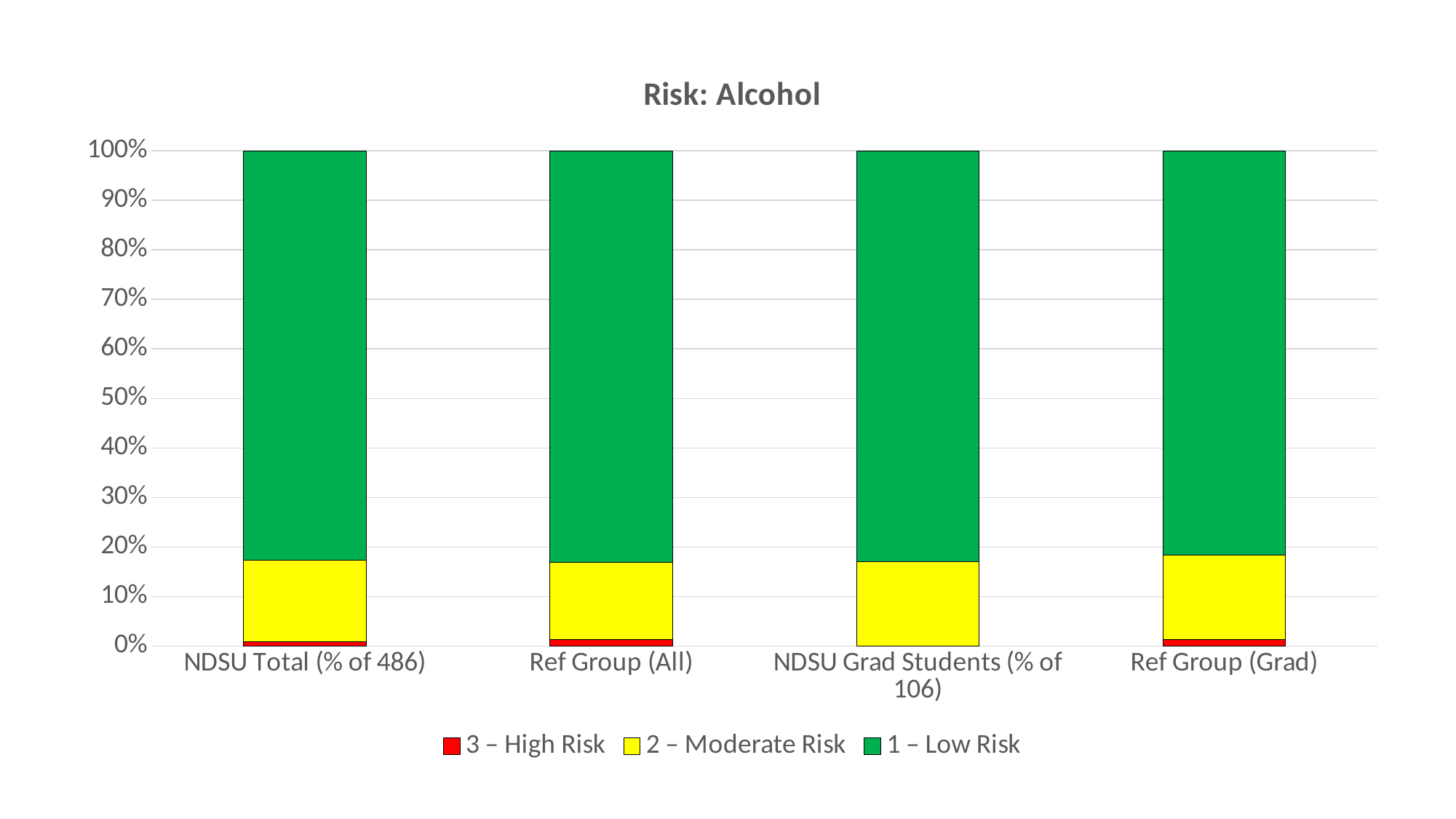
What is the total of the stacked bar for NDSU Total (% of 486)? 100% What is the total of the stacked bar for Ref Group (Grad)? 100% Is the 1 – Low Risk value for Ref Group (All) greater or less than 80%? greater Which colour represents the 3 – High Risk series? red What is the title of the chart? Risk: Alcohol What kind of chart is shown on the slide? stacked bar chart How many categories are shown on the x axis? 4 Is the 2 – Moderate Risk value for NDSU Grad Students (% of 106) greater or less than 30%? less Is the 2 – Moderate Risk value for NDSU Total (% of 486) greater or less than 20%? less How many series does the legend list? 3